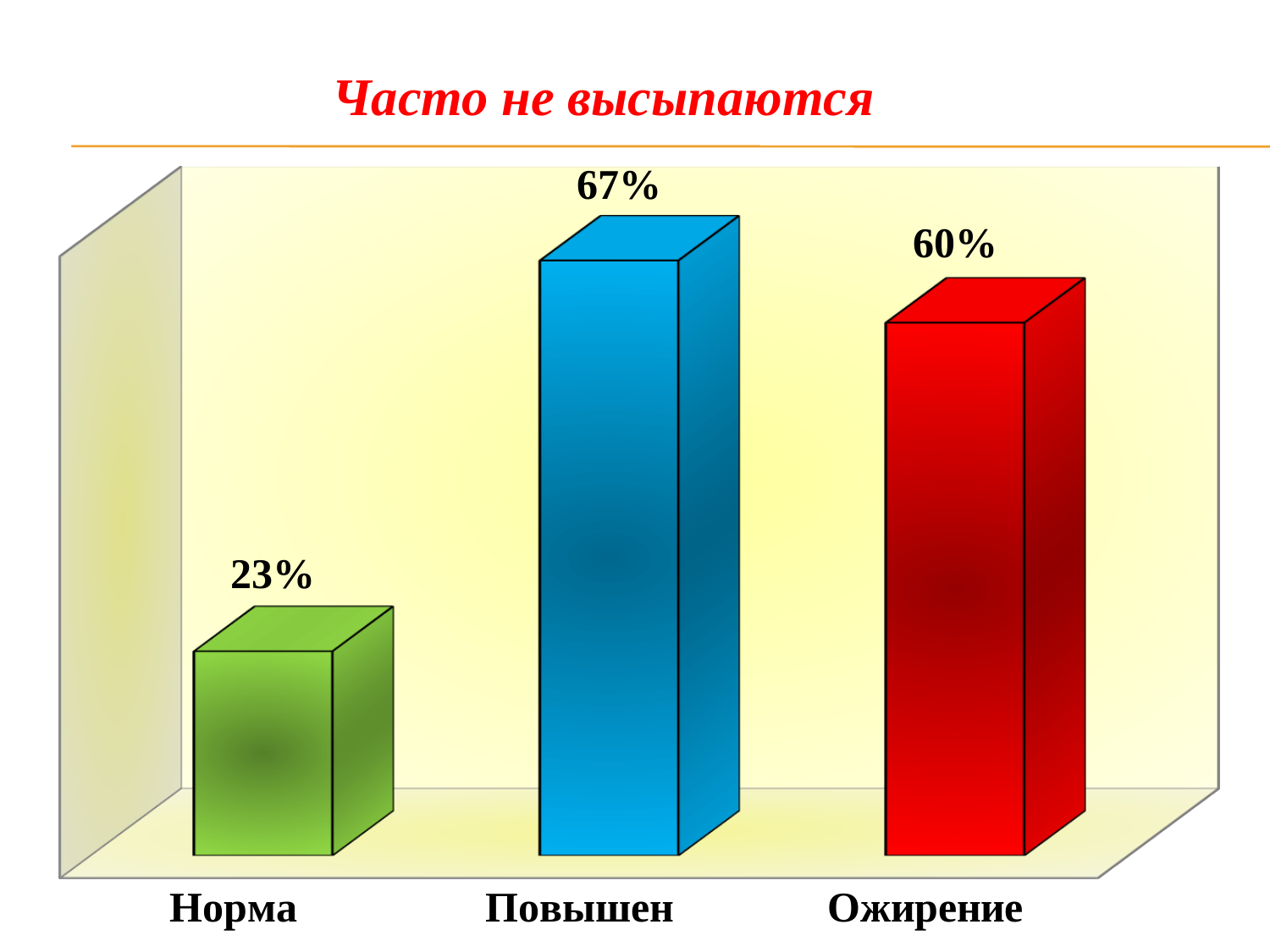
Which category has the lowest value? Норма What is the value for Повышен? 67% Which category has the highest value? Повышен What is the title of the chart? Часто не высыпаются What is the difference between the values for Повышен and Ожирение? 7% What is the value for Норма? 23% What is the difference between the values for Повышен and Норма? 44% What is the value for Ожирение? 60% Which is larger, the value for Норма or the value for Ожирение? Ожирение How many categories are shown in the chart? 3 What colour is the bar for Повышен? Blue What kind of chart is shown on the slide? Bar chart